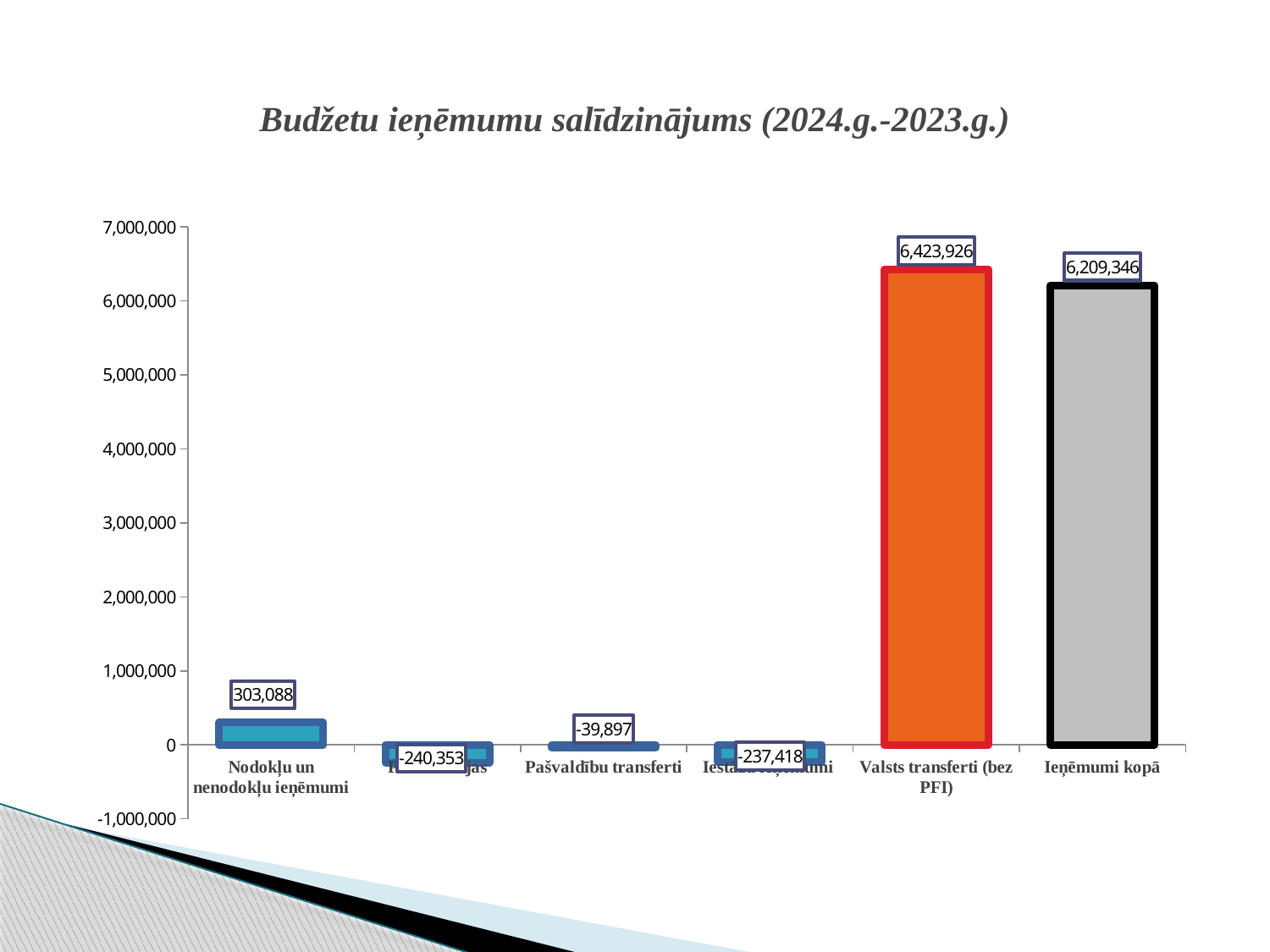
Which category has the highest value? Valsts transferti (bez PFI) What is the value for Valsts transferti (bez PFI)? 6,423,926 Which is larger, the value for Nodokļu un nenodokļu ieņēmumi or the value for Pašvaldību transferti? Nodokļu un nenodokļu ieņēmumi How many bars are shown in the chart? 6 What is the value for Pašvaldību transferti? -39,897 Is the value for Ieņēmumi kopā greater or less than 6,000,000? greater What is the value for Nodokļu un nenodokļu ieņēmumi? 303,088 What is the difference between the values for Nodokļu un nenodokļu ieņēmumi and Pašvaldību transferti? 342,985 How many bars have negative values? 3 What is the value for Ieņēmumi kopā? 6,209,346 What kind of chart is shown on the slide? bar chart What is the difference between the values for Valsts transferti (bez PFI) and Ieņēmumi kopā? 214,580